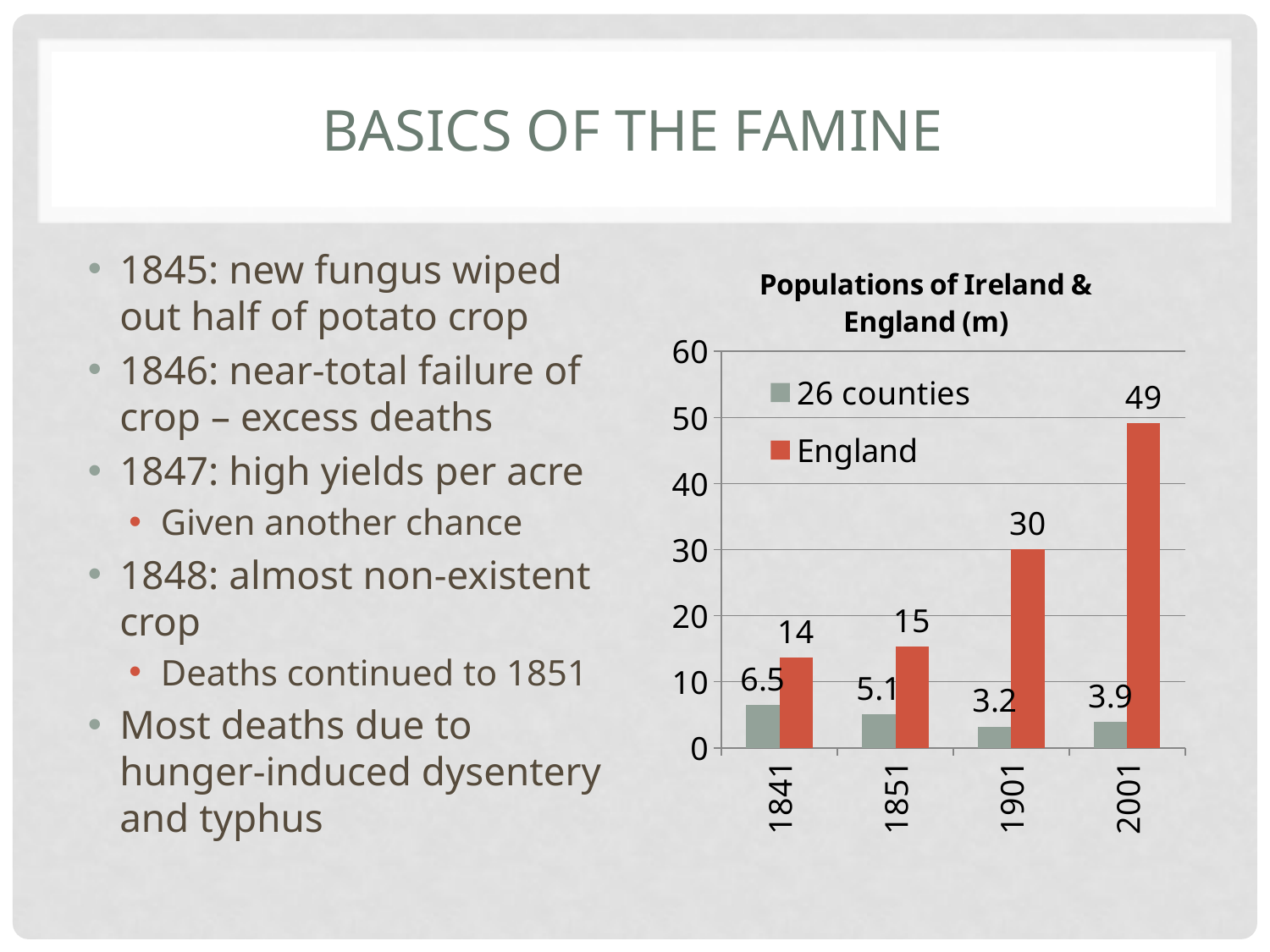
How many series does the legend list? 2 How many years are shown on the x axis? 4 In which year is the 26 counties value lowest? 1901 What kind of chart is shown on the slide? Bar chart What is the difference between the England and 26 counties values in 2001? 45.1 What is the value for England in 1901? 30 What is the value for 26 counties in 1901? 3.2 What is the value for 26 counties in 1841? 6.5 Which is larger: the 26 counties value in 1841 or in 1851? 1841 In which year is the England value highest? 2001 What is the value for England in 2001? 49 Does the England value rise or fall from 1841 to 2001? Rise